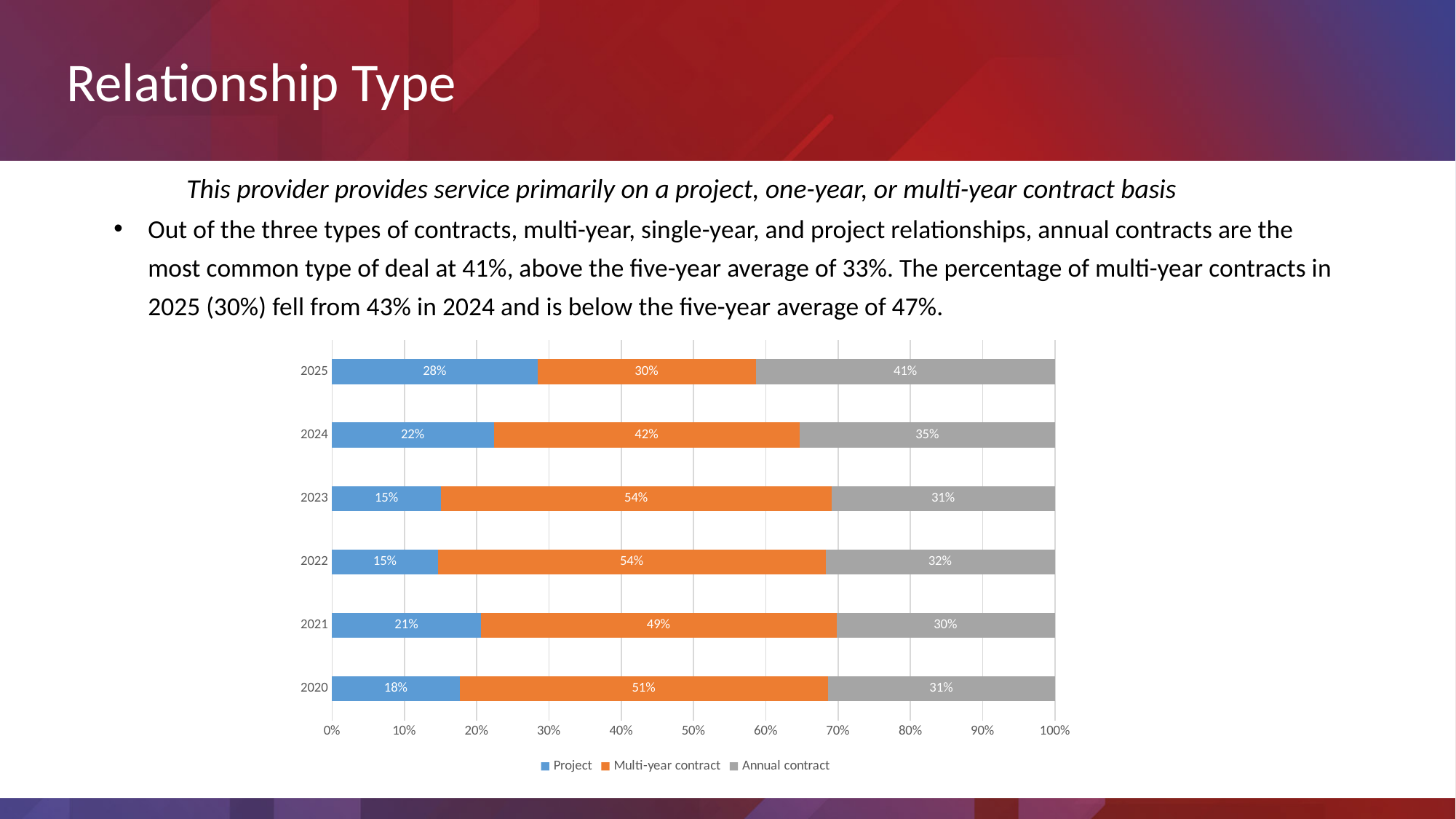
What is the value for Multi-year contract in 2025? 30% How many years are shown on the chart? 6 Which colour represents Annual contract in the chart? Grey What is the value for Annual contract in 2021? 30% Which is larger in 2020, the Project share or the Annual contract share? Annual contract In which year is the Project share highest? 2025 What is the value for Project in 2024? 22% Does the Multi-year contract share rise or fall from 2023 to 2025? Fall In which year is the Multi-year contract share lowest? 2025 What kind of chart is shown on the slide? Stacked bar chart What is the difference between the Multi-year contract values for 2024 and 2025? 12% How many series does the legend list? 3